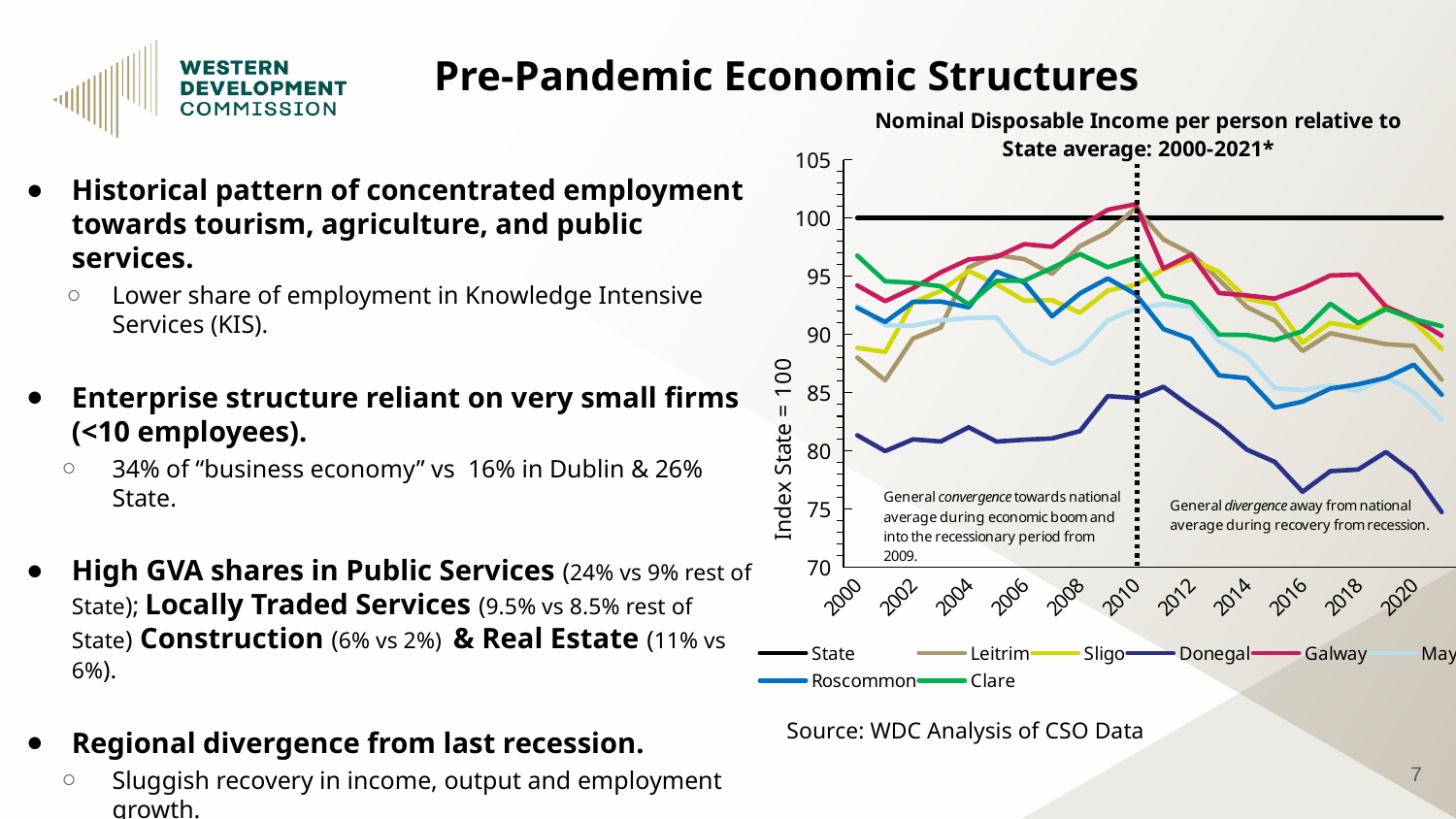
Which county's line is the lowest on the chart throughout the period? Donegal How many year labels are shown on the x axis? 11 What is the label on the chart's vertical axis? Index State = 100 Is the value for Donegal in 2016 greater or less than 80? less What type of chart is shown on the slide? line chart Is the value for Galway in 2018 greater or less than 90? greater How many series does the chart's legend list? 8 What is the title of the chart? Nominal Disposable Income per person relative to State average: 2000-2021* At what value does the State line sit across the whole chart? 100 Which is larger in 2000, the value for Clare or the value for Donegal? Clare Does the Donegal line generally rise or fall from 2012 to the end of the series? fall Which county has the highest value in 2018? Galway